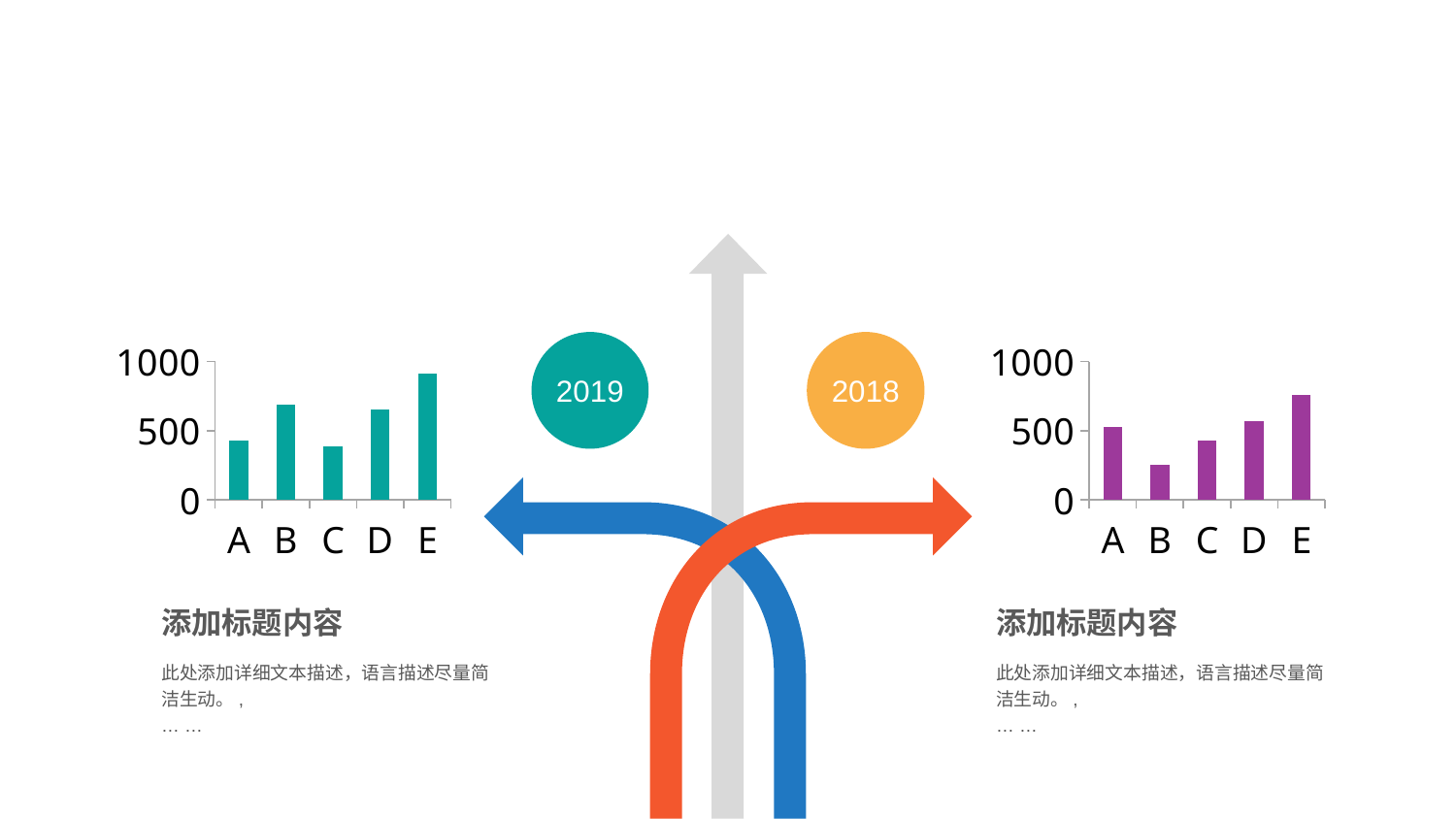
What kind of chart is the chart on the left side of the slide? bar chart In the chart on the right side of the slide, which category has the highest value? E In the chart on the left side of the slide, which is larger, the value for B or the value for C? B How many categories does the chart on the left side of the slide show? 5 In the chart on the left side of the slide, is the value for A greater or less than 500? less What kind of chart is the chart on the right side of the slide? bar chart In the chart on the left side of the slide, is the value for E greater or less than 500? greater In the chart on the left side of the slide, which category has the lowest value? C In the chart on the right side of the slide, is the value for B greater or less than 500? less In the chart on the left side of the slide, which category has the highest value? E In the chart on the right side of the slide, which is larger, the value for D or the value for C? D In the chart on the right side of the slide, which category has the lowest value? B